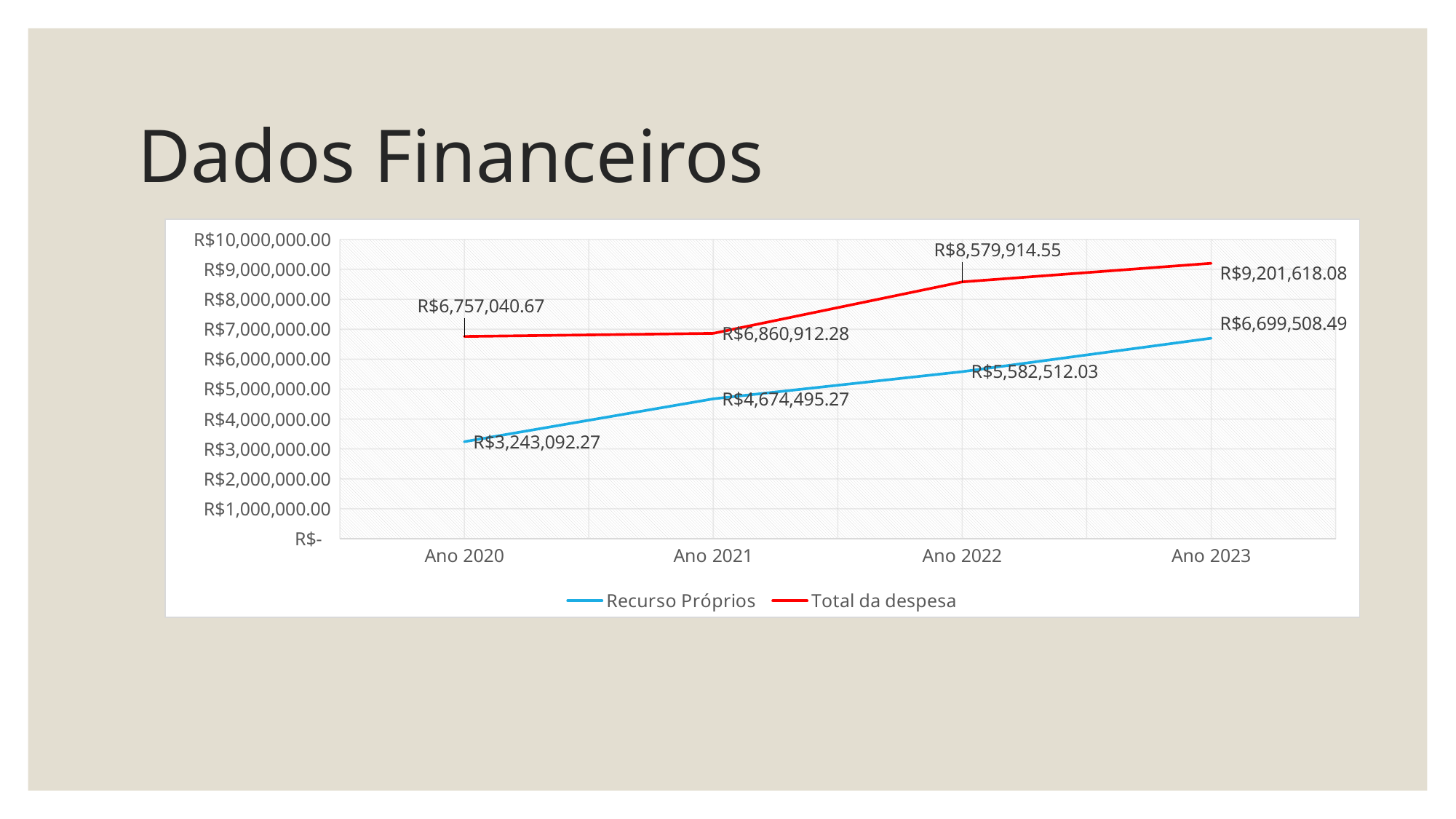
What is the value of Total da despesa for Ano 2022? R$8,579,914.55 Does Recurso Próprios rise or fall from Ano 2020 to Ano 2023? Rise What is the value of Recurso Próprios for Ano 2023? R$6,699,508.49 In which year is Total da despesa highest? Ano 2023 In which year is Recurso Próprios lowest? Ano 2020 What kind of chart is shown on the slide? Line chart How many years are shown on the x axis? 4 What is the value of Recurso Próprios for Ano 2020? R$3,243,092.27 Which is larger in Ano 2020: Recurso Próprios or Total da despesa? Total da despesa How many series does the legend list? 2 What is the value of Total da despesa for Ano 2021? R$6,860,912.28 What is the difference between Total da despesa and Recurso Próprios in Ano 2023? R$2,502,109.59